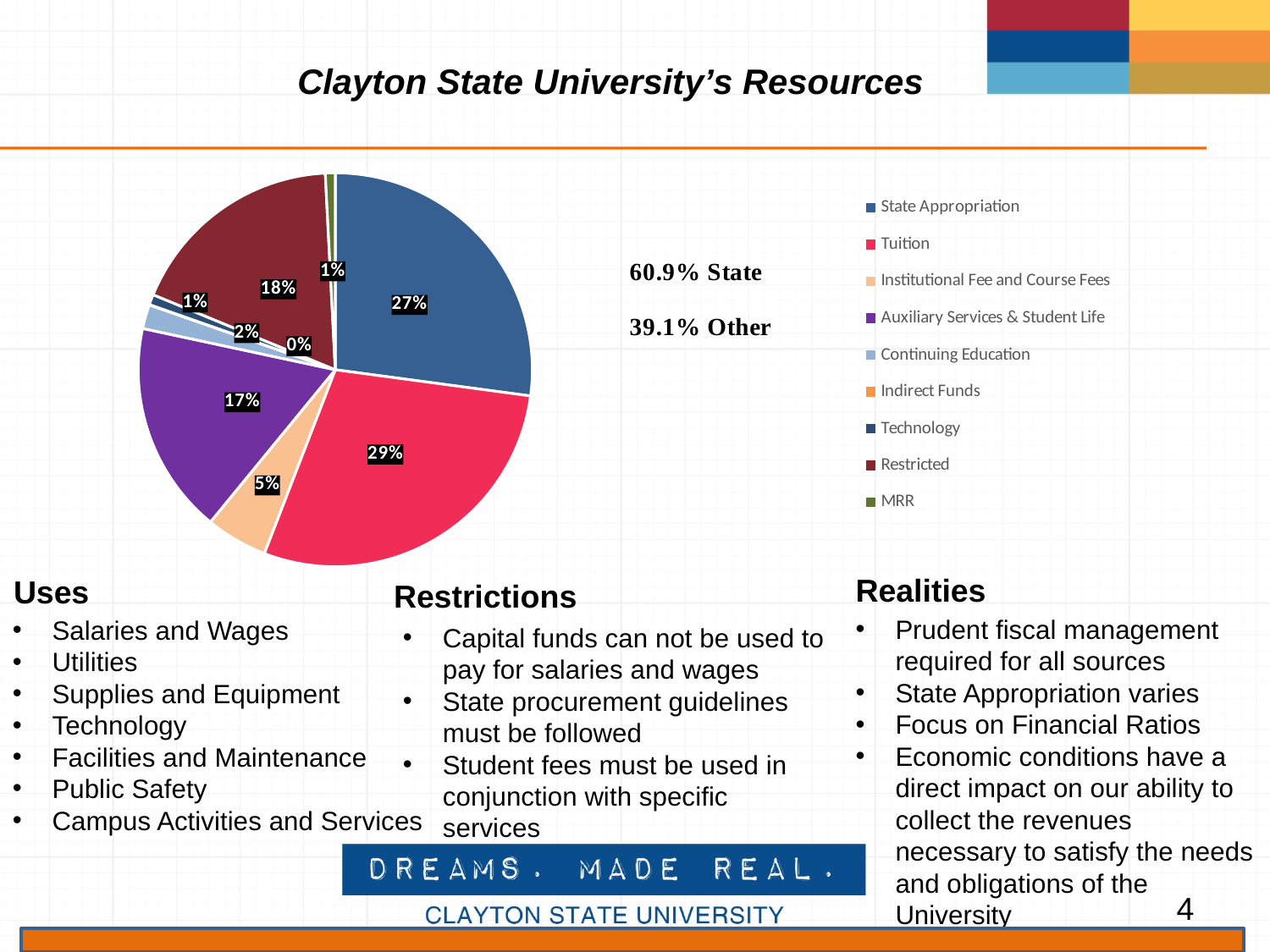
Which resource category has the smallest share, shown as 0%? Indirect Funds What percentage of Clayton State University's resources comes from Tuition? 29% How many categories does the legend of the pie chart list? 9 What percentage of resources comes from State Appropriation? 27% What percentage is shown for Institutional Fee and Course Fees? 5% Which is larger, the share for Restricted or the share for Auxiliary Services & Student Life? Restricted What share of the pie is Auxiliary Services & Student Life? 17% What percentage is shown for Restricted funds? 18% According to the text next to the chart, what percentage of resources is labelled as State? 60.9% What is the difference in percentage points between Tuition and State Appropriation? 2% What type of chart is shown on the slide? pie chart Which resource category has the largest share of the pie? Tuition